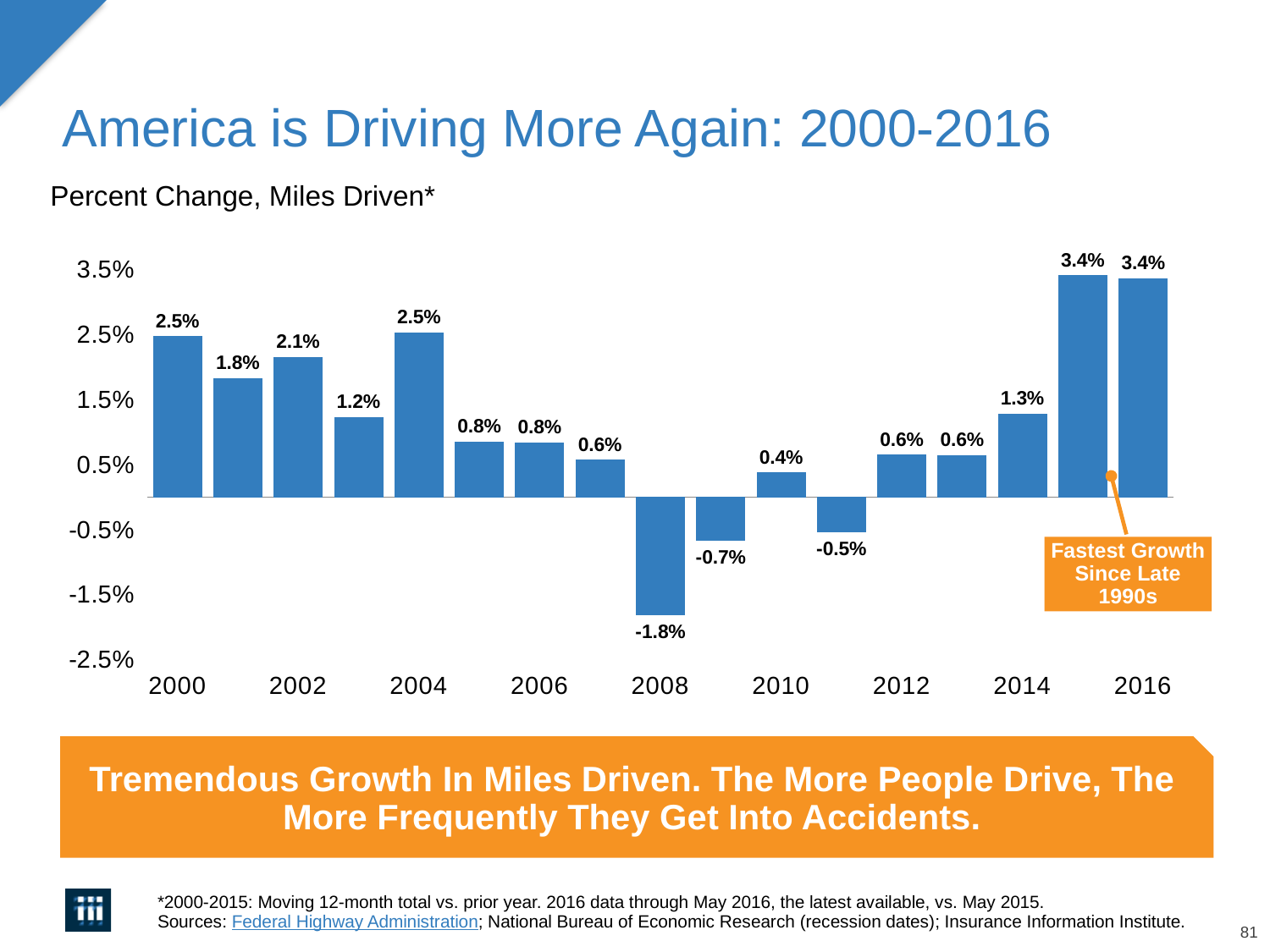
Which year has a larger percent change in miles driven, 2004 or 2006? 2004 Is the value for 2008 greater or less than -1.5%? less What is the percent change in miles driven for 2008? -1.8% Do the values rise or fall from 2012 to 2016? Rise What is the percent change in miles driven for 2016? 3.4% Which year has the lowest percent change in miles driven? 2008 What is the highest percent change value shown on the chart? 3.4% What is the percent change in miles driven for 2014? 1.3% What kind of chart is shown on the slide? Bar chart How many bars are plotted on the chart? 17 What is the difference between the percent change for 2016 and for 2014? 2.1 percentage points What is the percent change in miles driven for 2010? 0.4%